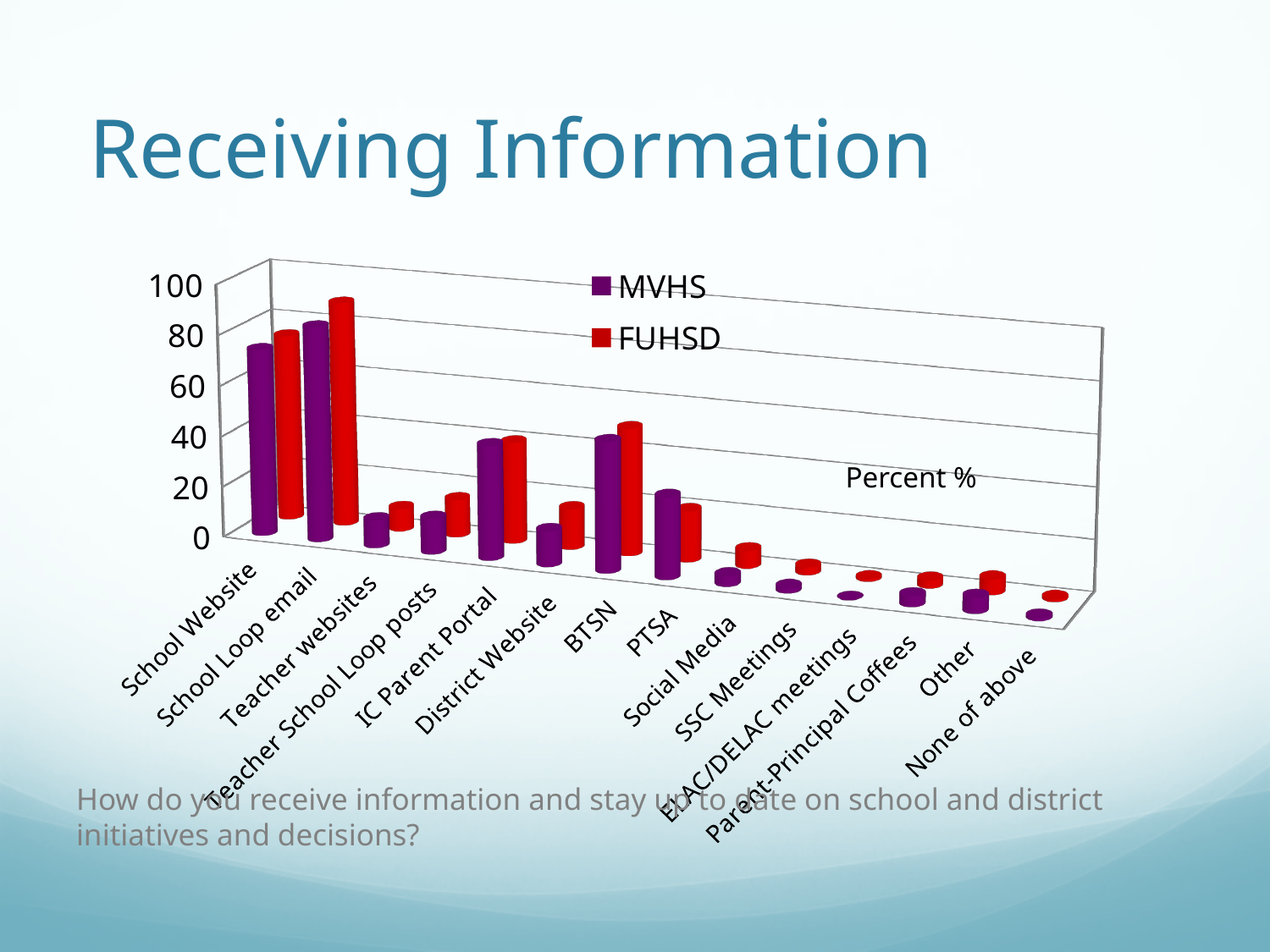
Is the MVHS value for School Website greater or less than 60? greater How many series does the legend list? 2 Which two series are listed in the legend? MVHS and FUHSD Is the MVHS value for Social Media greater or less than 20? less Is the FUHSD value for Teacher websites greater or less than 40? less What kind of chart is shown on the slide? bar chart Which is larger for MVHS: School Loop email or Teacher websites? School Loop email Which category has the highest value for the MVHS series? School Loop email Which is larger for FUHSD: BTSN or SSC Meetings? BTSN How many categories are shown on the x axis? 14 Which category has the highest value for the FUHSD series? School Loop email